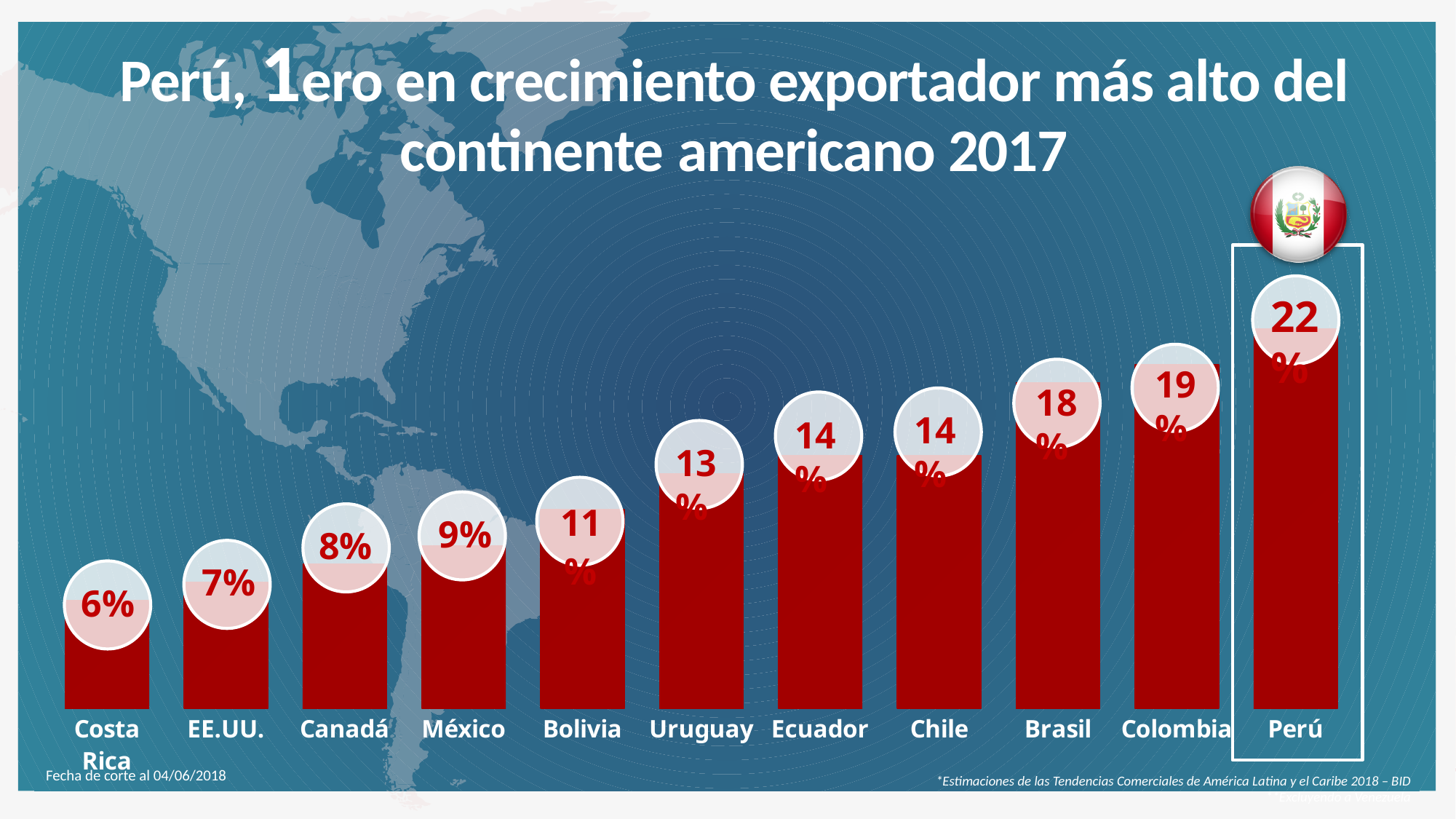
What value is shown for Costa Rica? 6% What is the export growth value shown for Perú? 22% What value is shown for Uruguay? 13% What is the difference between the values for Brasil and Bolivia? 7% Which country has the lowest value in the chart? Costa Rica What type of chart is shown on the slide? Bar chart Do the values rise or fall from left to right across the chart? Rise Which has a larger value, México or Canadá? México What value is shown for Brasil? 18% Which country has the highest value in the chart? Perú What is the difference between the values for Perú and Colombia? 3% How many countries are shown in the chart? 11